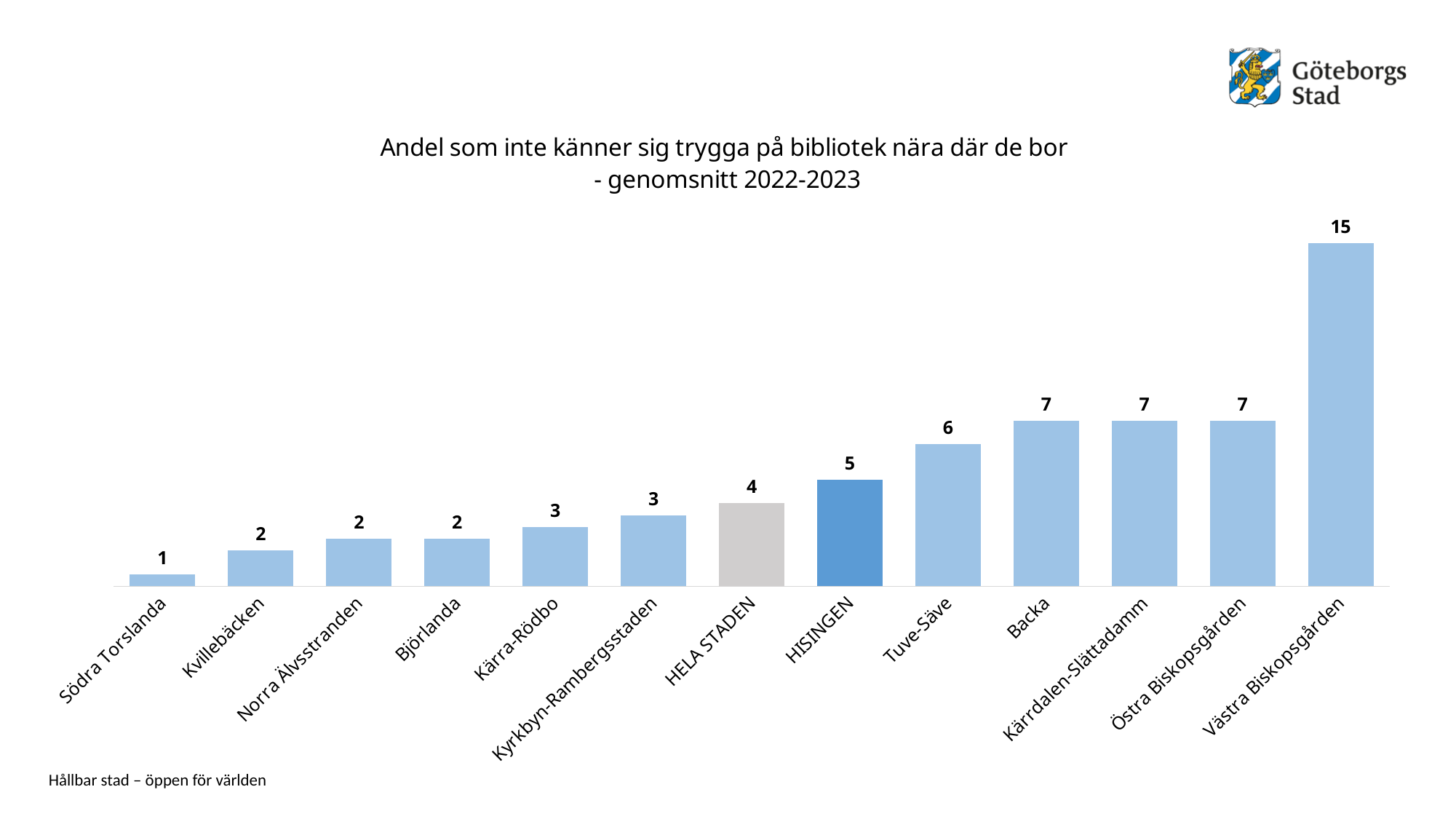
What kind of chart is shown on the slide? Bar chart What is the value for Västra Biskopsgården? 15 What is the difference between the values for Västra Biskopsgården and Östra Biskopsgården? 8 Which category has the highest value? Västra Biskopsgården Which is larger, the value for Backa or the value for Kärra-Rödbo? Backa What is the value for HELA STADEN? 4 What is the difference between the values for HISINGEN and HELA STADEN? 1 Which category has the lowest value? Södra Torslanda What is the value for HISINGEN? 5 How many categories are shown on the x axis? 13 What is the title of the chart? Andel som inte känner sig trygga på bibliotek nära där de bor - genomsnitt 2022-2023 What is the value for Tuve-Säve? 6